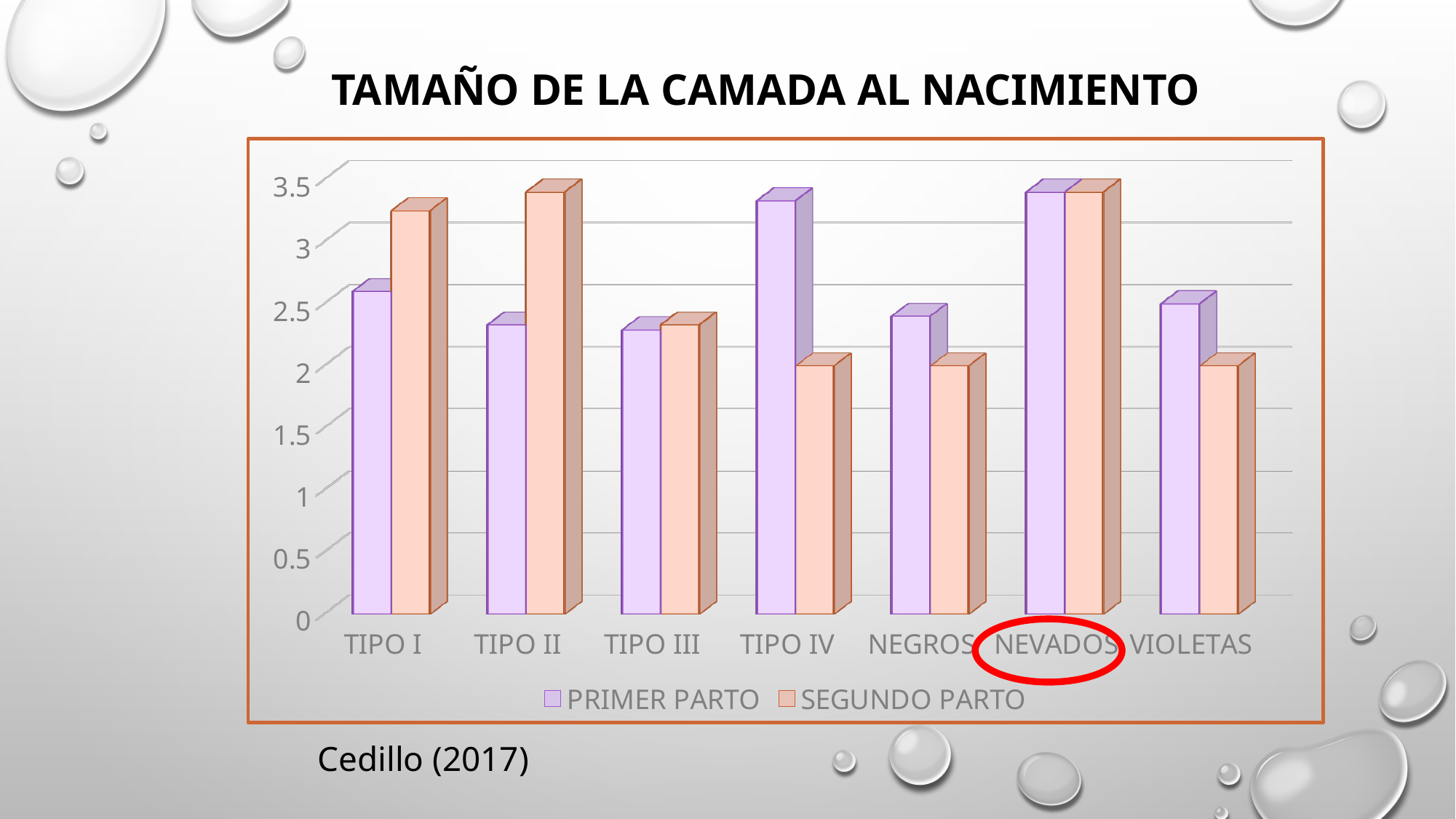
For VIOLETAS, which series has the larger value, PRIMER PARTO or SEGUNDO PARTO? PRIMER PARTO Is the SEGUNDO PARTO value for TIPO IV greater or less than 2.5? less For TIPO IV, which series has the larger value, PRIMER PARTO or SEGUNDO PARTO? PRIMER PARTO Is the PRIMER PARTO value for TIPO I greater or less than 3? less How many categories are shown on the x axis of the chart? 7 Which category label on the x axis is circled in red? NEVADOS What kind of chart is shown on the slide? bar chart What are the two series named in the legend? PRIMER PARTO and SEGUNDO PARTO Is the SEGUNDO PARTO value for TIPO II greater or less than 3? greater How many series does the legend list? 2 For TIPO I, which series has the larger value, PRIMER PARTO or SEGUNDO PARTO? SEGUNDO PARTO